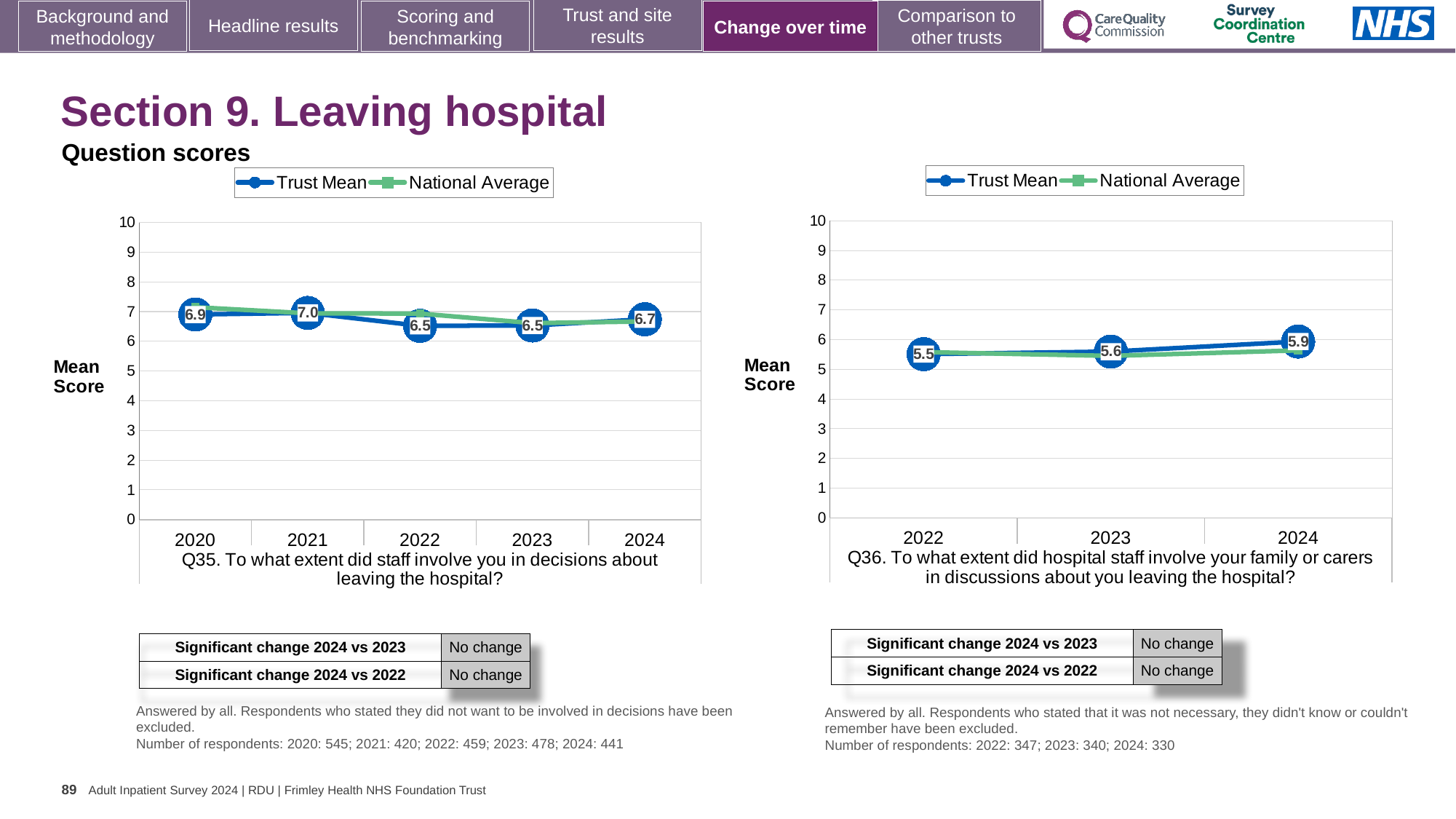
In the Q36 chart (right), which year has the lowest Trust Mean score? 2022 In the Q35 chart (left), is the Trust Mean score for 2020 greater or less than 6? greater In the Q35 chart (left), what is the Trust Mean score for 2024? 6.7 In the Q36 chart (right), what is the Trust Mean score for 2024? 5.9 In the Q35 chart (left), what is the difference between the Trust Mean scores for 2021 and 2022? 0.5 What kind of chart is the Q36 chart (right)? Line chart How many years are plotted on the x axis of the Q36 chart (right)? 3 In the Q35 chart (left), which year has the highest Trust Mean score? 2021 In the Q36 chart (right), what is the Trust Mean score for 2022? 5.5 In the Q35 chart (left), what is the Trust Mean score for 2021? 7.0 In the Q36 chart (right), what is the difference between the Trust Mean scores for 2024 and 2022? 0.4 How many series does the legend of the Q35 chart (left) list? 2